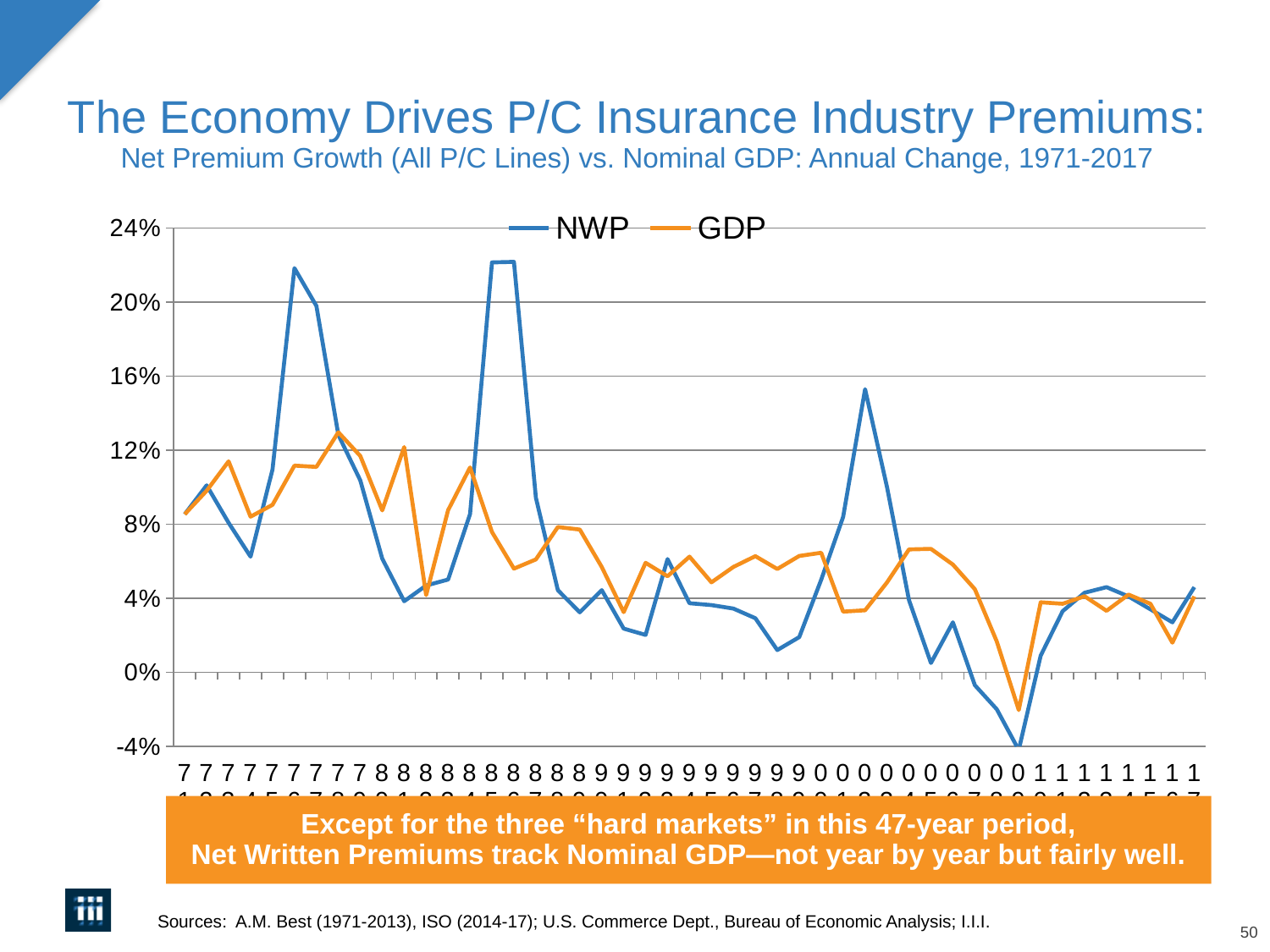
What are the two series named in the legend? NWP and GDP What colour is the NWP line? blue Over the full period from 1971 to 2017, do the NWP values generally rise or fall? fall How many years (data points per series) does the chart cover? 47 Is the highest value of the NWP series greater or less than 20%? greater Is the lowest value of the NWP series greater or less than 0%? less What kind of chart is shown on the slide? line chart Is the highest value of the GDP series greater or less than 16%? less Which series drops to the lower minimum value, NWP or GDP? NWP How many series does the legend list? 2 Which series reaches the higher peak value, NWP or GDP? NWP